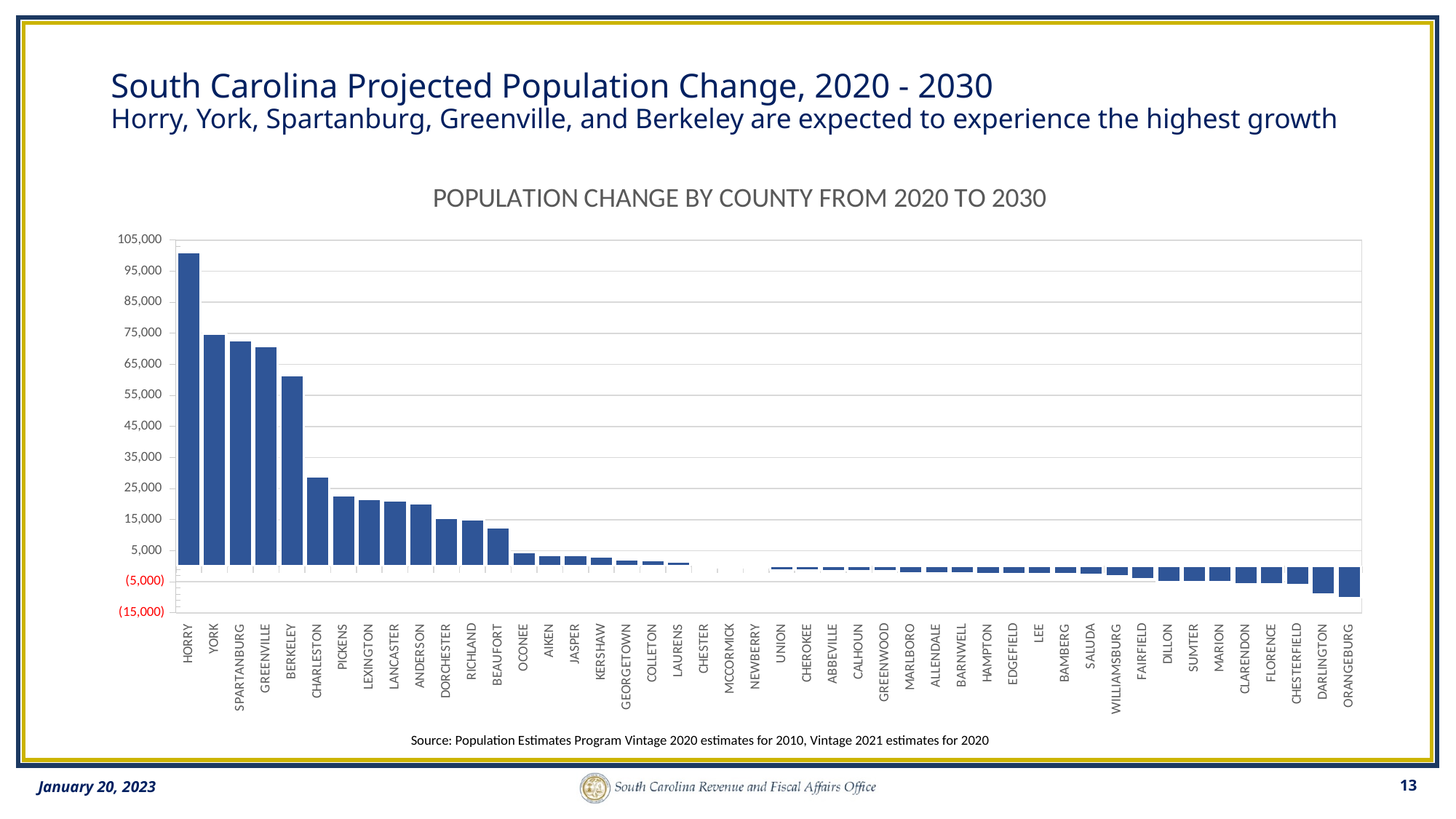
What is the title of the chart? POPULATION CHANGE BY COUNTY FROM 2020 TO 2030 Is the value for Horry greater or less than 95,000? greater Do the values rise or fall moving from left to right along the x axis? fall Which county has the highest projected population change? Horry Is the value for Beaufort greater or less than 5,000? greater Which county has the lowest projected population change? Orangeburg Which has the larger projected population change, York or Greenville? York What kind of chart is shown on the slide? bar chart Is the value for Charleston greater or less than 25,000? greater How many counties are plotted on the chart? 46 Which has the larger projected population change, Charleston or Pickens? Charleston